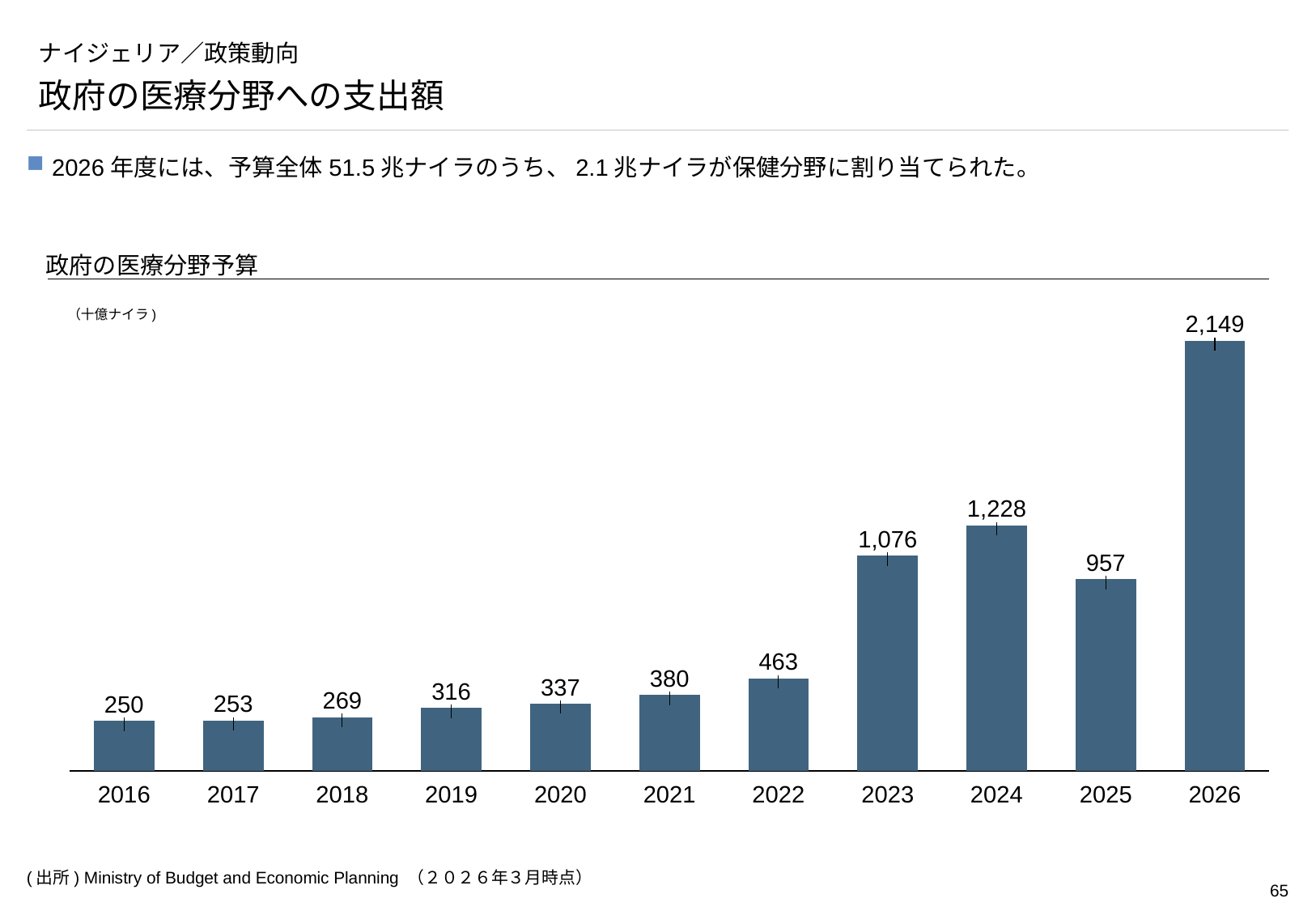
What kind of chart is this? bar chart How many years are shown on the x axis? 11 Which is larger, the value for 2024 or the value for 2025? 2024 What is the value for 2023? 1,076 What is the difference between the values for 2026 and 2025? 1,192 What is the difference between the values for 2024 and 2023? 152 What unit is shown for the chart values? 十億ナイラ Do the values generally rise or fall from 2016 to 2024? rise What is the value for 2026? 2,149 What is the value for 2019? 316 Which year has the highest value? 2026 Which year has the lowest value? 2016